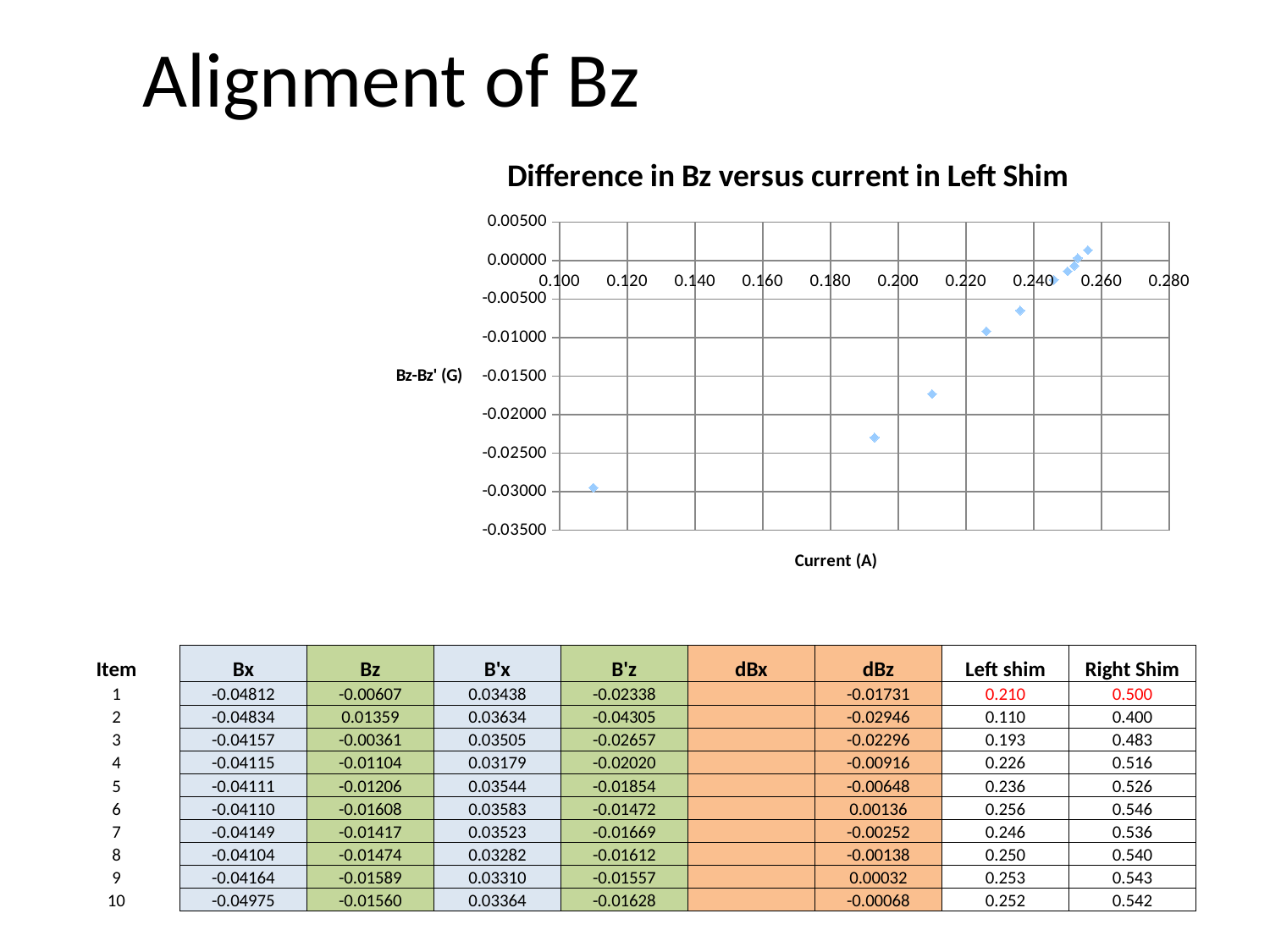
Is the value of the leftmost point (at about 0.110 A) greater or less than -0.02500? less Is the value of the point at about 0.190 A greater or less than -0.02000? less Is the value of the point at about 0.210 A greater or less than -0.02000? greater Which has the larger Bz-Bz' value: the point at about 0.210 A or the point at about 0.236 A? The point at about 0.236 A As the current increases along the x axis, do the Bz-Bz' values rise or fall? Rise What kind of chart is shown on the slide? Scatter chart What is the title of the chart? Difference in Bz versus current in Left Shim What is the label of the x axis of the chart? Current (A) Which point has the lowest Bz-Bz' value: the one at about 0.110 A or the one at about 0.190 A? The one at about 0.110 A